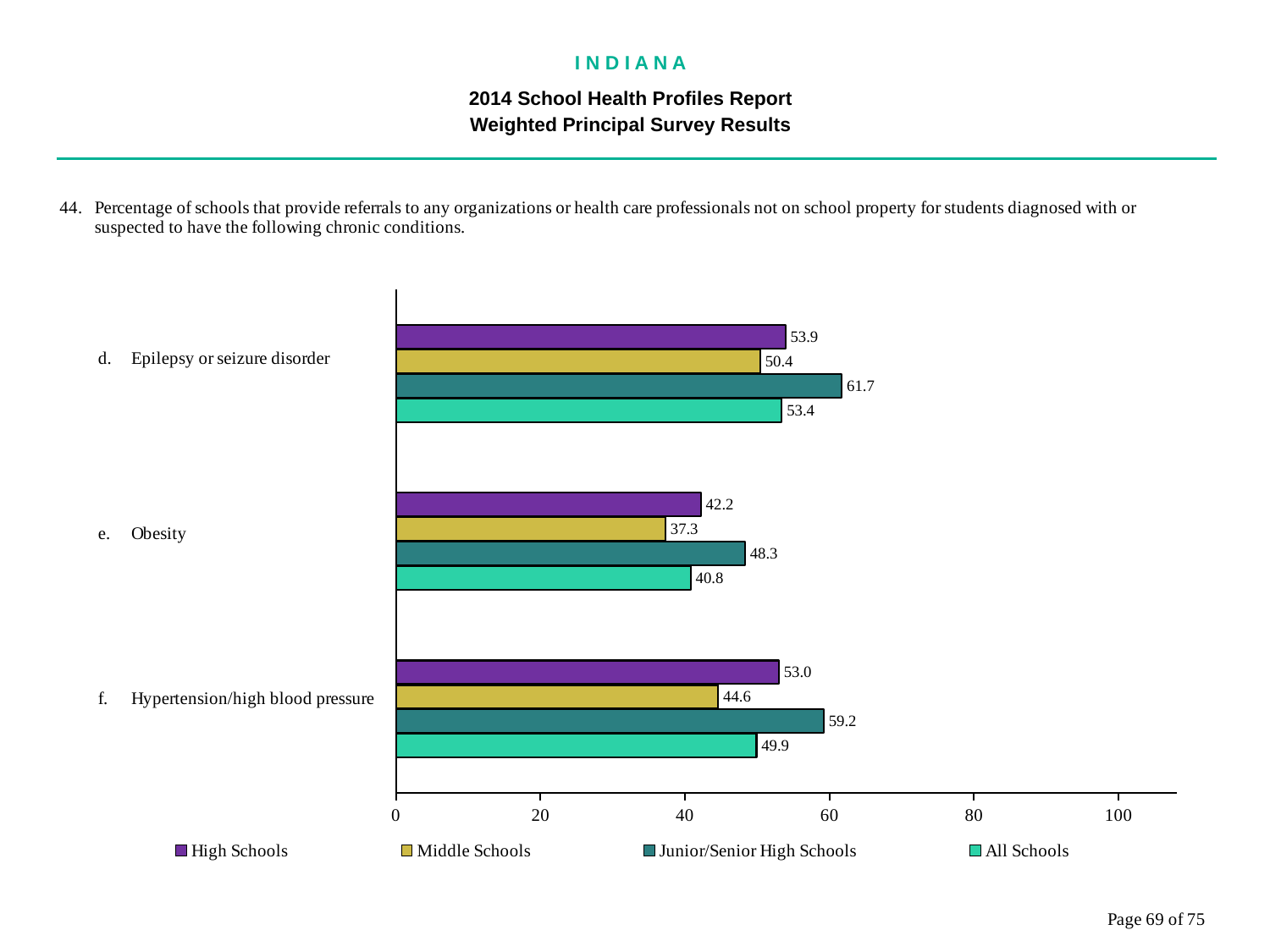
Which chronic condition has the highest value for High Schools? Epilepsy or seizure disorder Is the value for Middle Schools for Epilepsy or seizure disorder greater or less than 40? greater What is the value for Junior/Senior High Schools for Epilepsy or seizure disorder? 61.7 Which chronic condition has the lowest value for All Schools? Obesity How many series does the legend list? 4 Which legend entry is shown in purple? High Schools Which is larger for Obesity: the High Schools value or the All Schools value? High Schools What is the difference between the Junior/Senior High Schools and Middle Schools values for Hypertension/high blood pressure? 14.6 What kind of chart is shown on the slide? bar chart What is the value for Middle Schools for Obesity? 37.3 How many chronic conditions are shown on the chart? 3 What is the value for All Schools for Hypertension/high blood pressure? 49.9